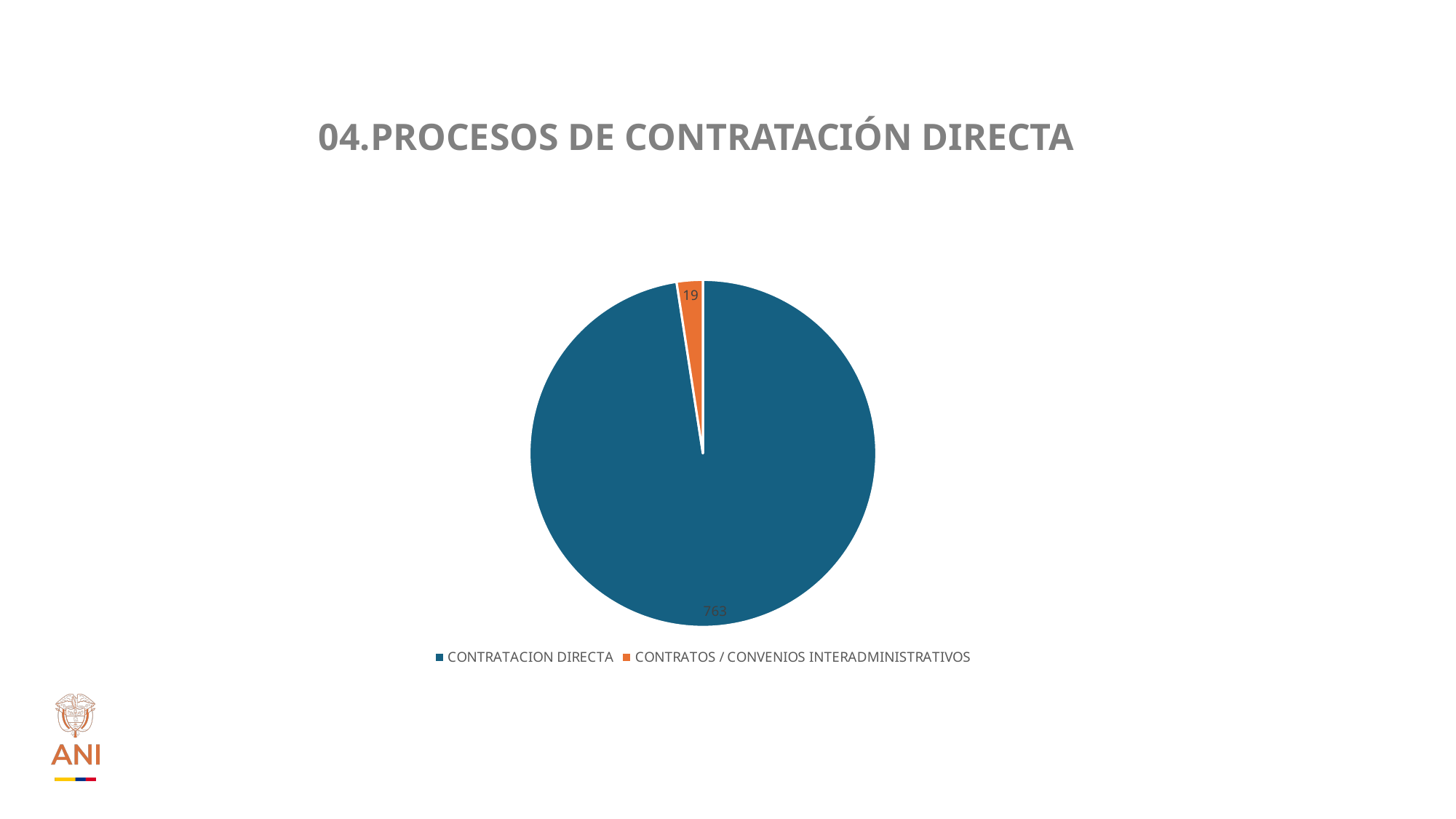
What is the difference between the values for CONTRATACION DIRECTA and CONTRATOS / CONVENIOS INTERADMINISTRATIVOS? 744 What is the total of all slices in the pie chart? 782 How many slices does the pie chart have? 2 Which category has the smallest slice? CONTRATOS / CONVENIOS INTERADMINISTRATIVOS What is the title of the slide? 04.PROCESOS DE CONTRATACIÓN DIRECTA What type of chart is shown on the slide? pie chart Which category has the largest slice? CONTRATACION DIRECTA What colour is the slice for CONTRATOS / CONVENIOS INTERADMINISTRATIVOS? orange What is the value for CONTRATOS / CONVENIOS INTERADMINISTRATIVOS? 19 What is the value for CONTRATACION DIRECTA? 763 Which is larger, CONTRATACION DIRECTA or CONTRATOS / CONVENIOS INTERADMINISTRATIVOS? CONTRATACION DIRECTA